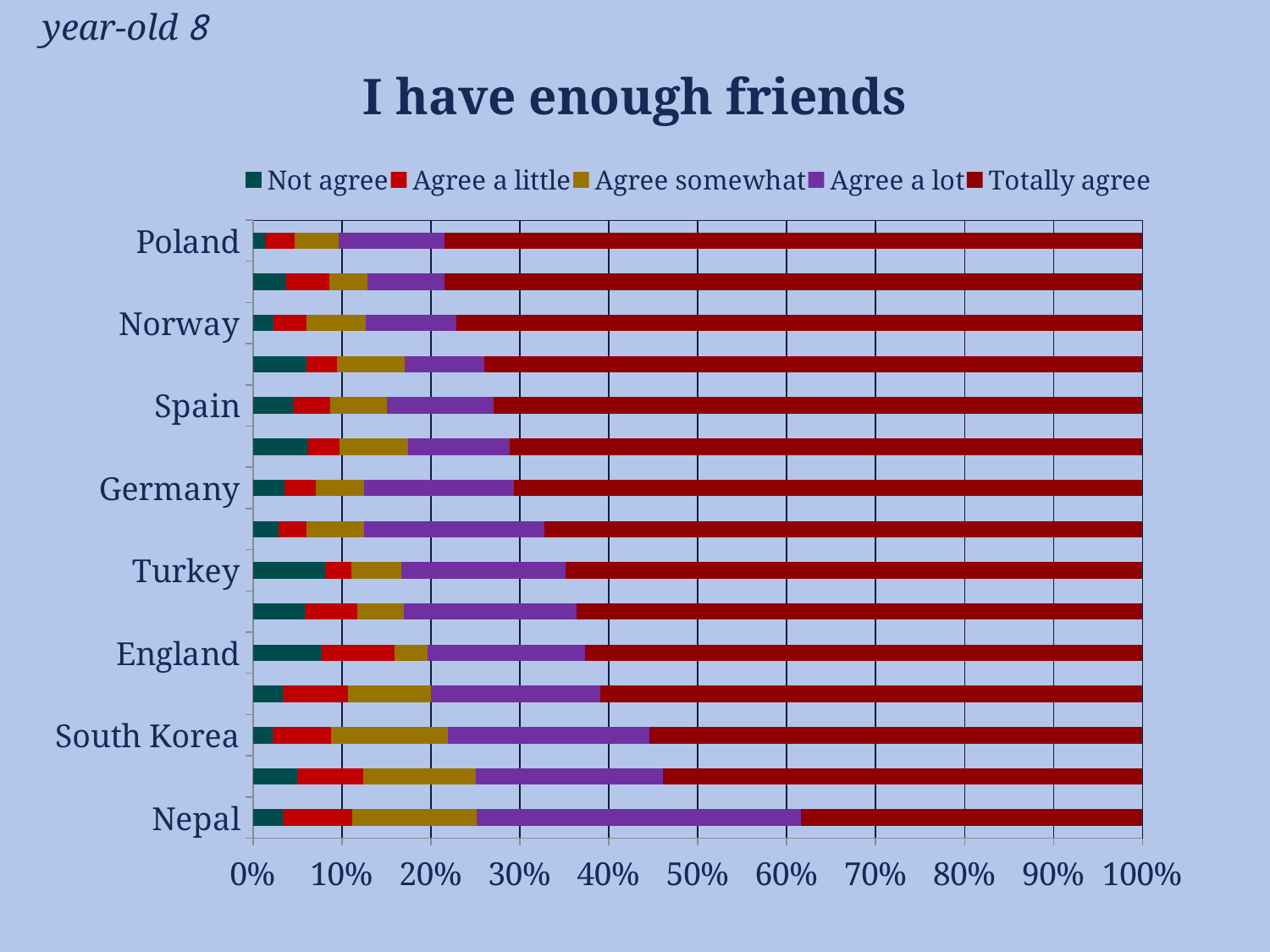
Which labelled country has the largest 'Agree a lot' share? Nepal Going down the chart from Poland to Nepal, do the 'Totally agree' segments get larger or smaller? smaller Is the 'Totally agree' value for Nepal greater or less than 40%? less Is the 'Not agree' value for Turkey greater or less than 10%? less Is the 'Totally agree' value for Poland greater or less than 70%? greater What is the title of the chart? I have enough friends What kind of chart is shown on the slide? Stacked bar chart How many series does the legend list? 5 How many country labels are shown on the vertical axis? 8 Which labelled country has the smallest 'Totally agree' share? Nepal Which legend entry is shown in dark red? Totally agree Which has the larger 'Totally agree' share, Poland or Nepal? Poland